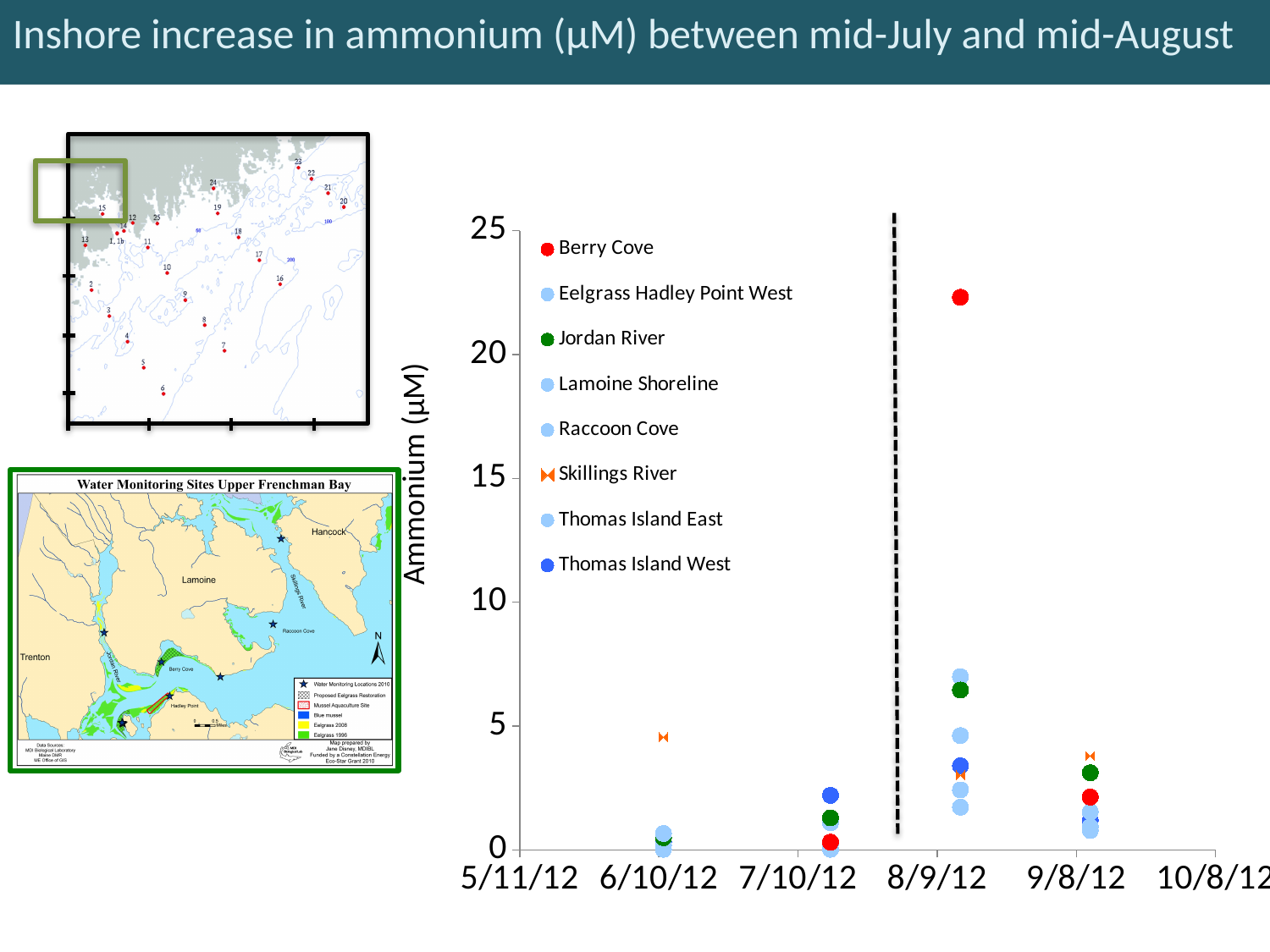
On the ammonium chart, which is larger near 8/9/12: the Berry Cove value or the Jordan River value? Berry Cove How many date labels are shown on the x axis of the ammonium chart? 6 Does the Berry Cove value on the ammonium chart rise or fall between 7/10/12 and 8/9/12? rise Which series has the highest plotted value on the ammonium chart? Berry Cove Is the Berry Cove value near 7/10/12 on the ammonium chart greater or less than 5? less Is the highest Berry Cove value on the ammonium chart greater or less than 20? greater What is the label on the vertical axis of the ammonium chart? Ammonium (µM) Is the Skillings River value near 6/10/12 on the ammonium chart greater or less than 10? less What kind of chart is shown on the right of the slide? scatter chart How many series does the legend of the ammonium chart list? 8 Which series on the ammonium chart is marked with an orange bow-tie symbol in the legend? Skillings River